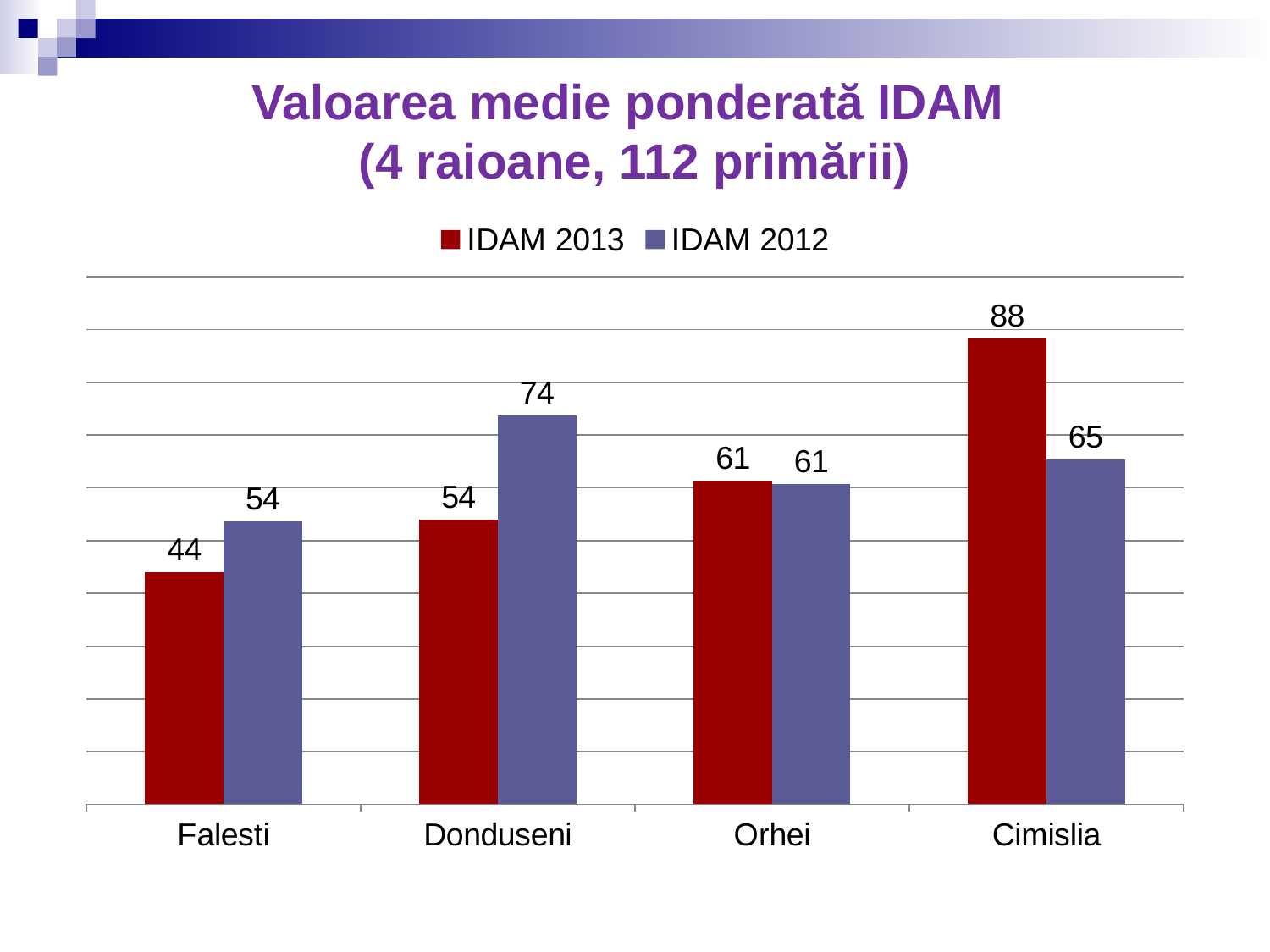
Which category has the highest IDAM 2013 value? Cimislia What is the difference between the IDAM 2012 and IDAM 2013 values for Donduseni? 20 Which is larger for Falesti, the IDAM 2013 value or the IDAM 2012 value? IDAM 2012 Which category has the lowest IDAM 2012 value? Falesti What is the IDAM 2012 value for Cimislia? 65 What kind of chart is shown on the slide? Bar chart How many categories are shown on the x axis? 4 Which category has the lowest IDAM 2013 value? Falesti How many series does the legend list? 2 What is the IDAM 2012 value for Donduseni? 74 What is the IDAM 2013 value for Falesti? 44 What is the difference between the IDAM 2013 and IDAM 2012 values for Cimislia? 23